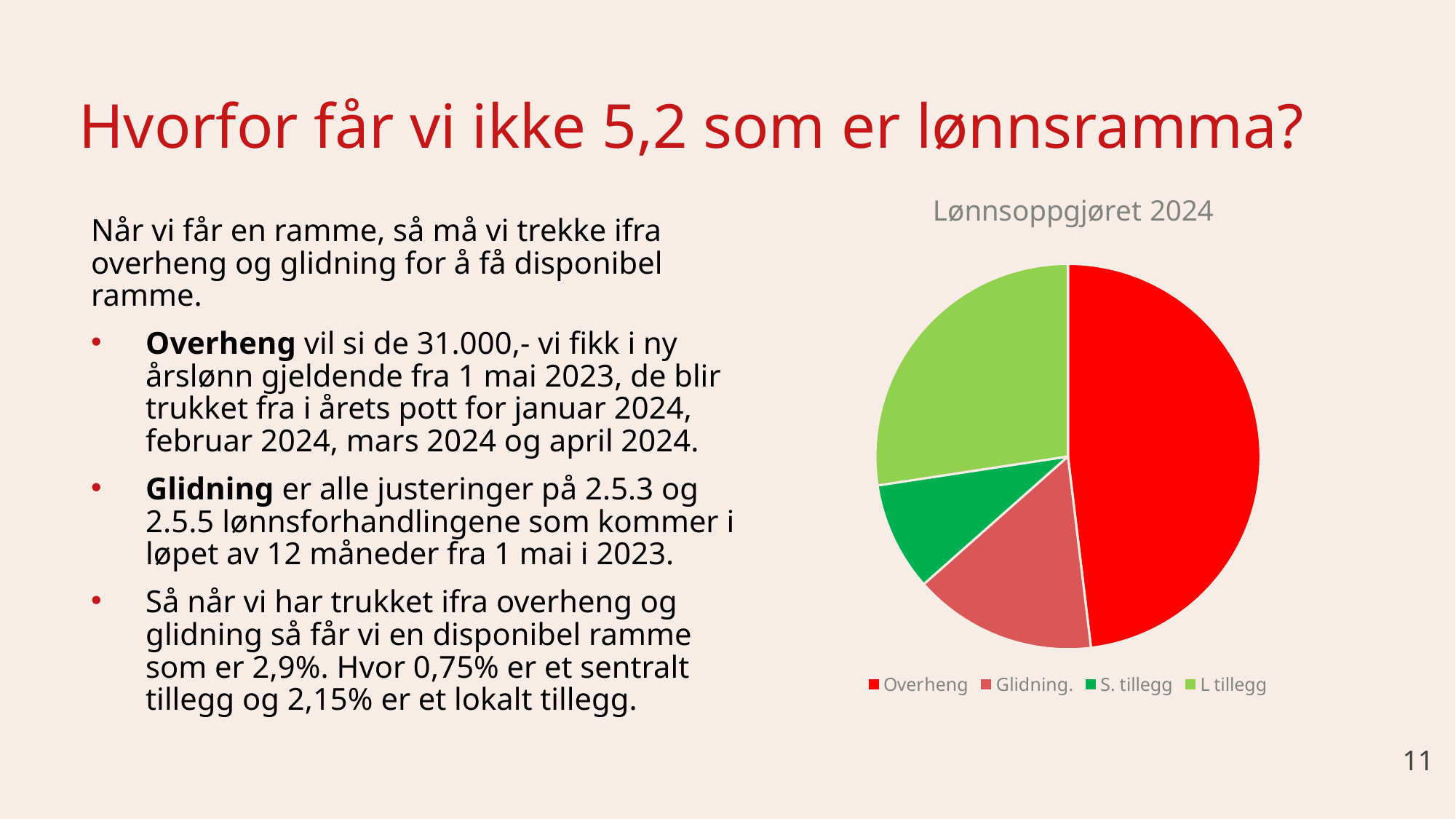
What kind of chart is shown on the slide? pie chart Which category has the smallest slice of the pie? S. tillegg Which category has the largest slice of the pie? Overheng What colour is the Overheng slice in the pie chart? red Which slice is larger, Glidning. or L tillegg? L tillegg How many entries does the chart legend list? 4 What is the title of the chart? Lønnsoppgjøret 2024 Which slice is larger, Overheng or L tillegg? Overheng Which slice is larger, Glidning. or S. tillegg? Glidning. How many slices does the pie chart have? 4